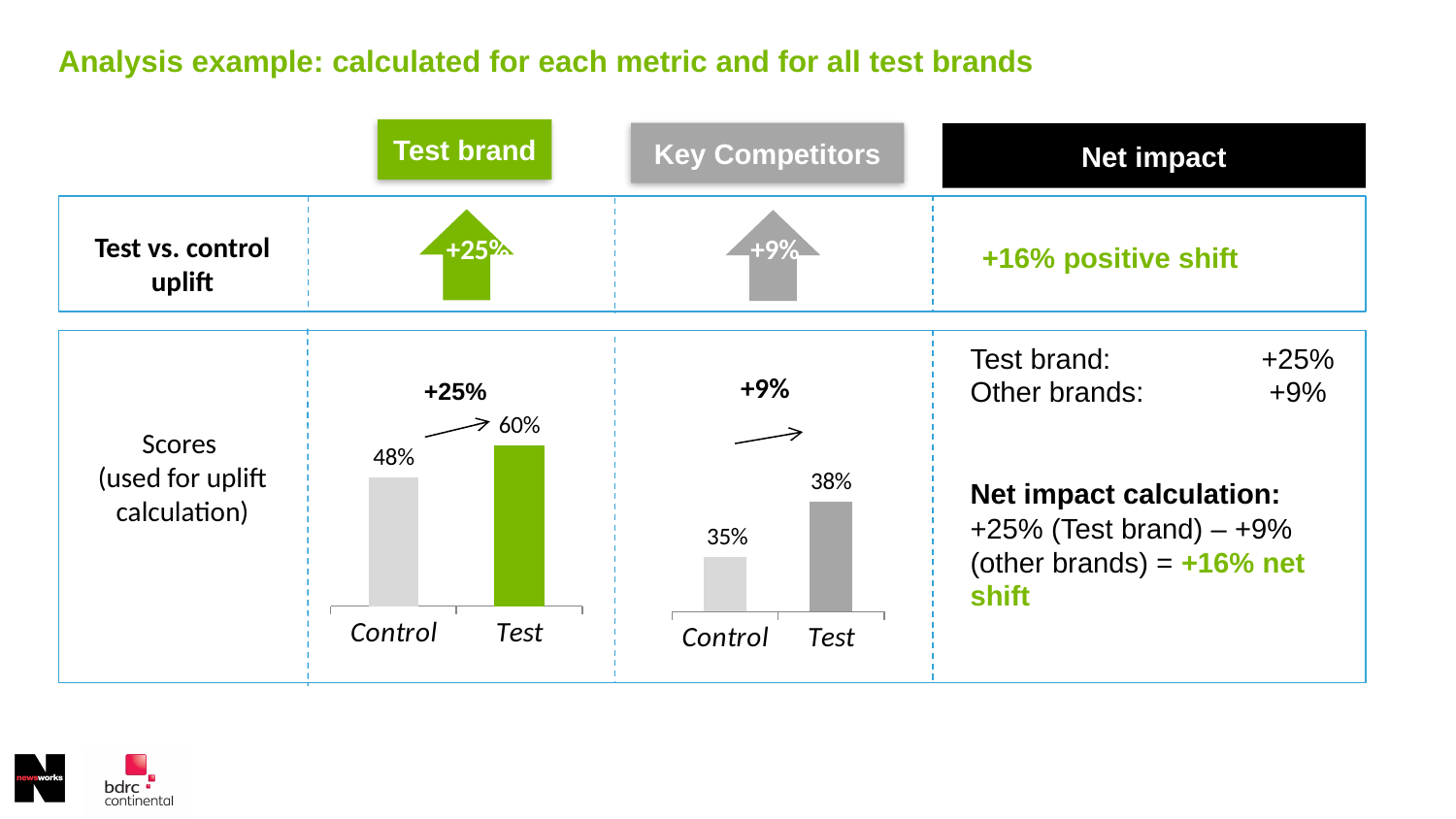
Is the Test value in the Test brand chart larger or smaller than the Test value in the Key Competitors chart? larger In the Test brand chart, what is the value for Control? 48% How many bars are shown in the Key Competitors chart? 2 What type of chart is used in the Test brand panel? bar chart In the Test brand chart, what is the value for Test? 60% In the Key Competitors chart, which category has the lower value? Control In the Key Competitors chart, what is the value for Test? 38% In the Test brand chart, which category has the higher value? Test In the Key Competitors chart, what is the difference between the Test and Control values? 3% In the Key Competitors chart, what is the value for Control? 35% In the Test brand chart, what is the difference between the Test and Control values? 12% In the Test brand chart, what uplift percentage is labelled above the bars? +25%